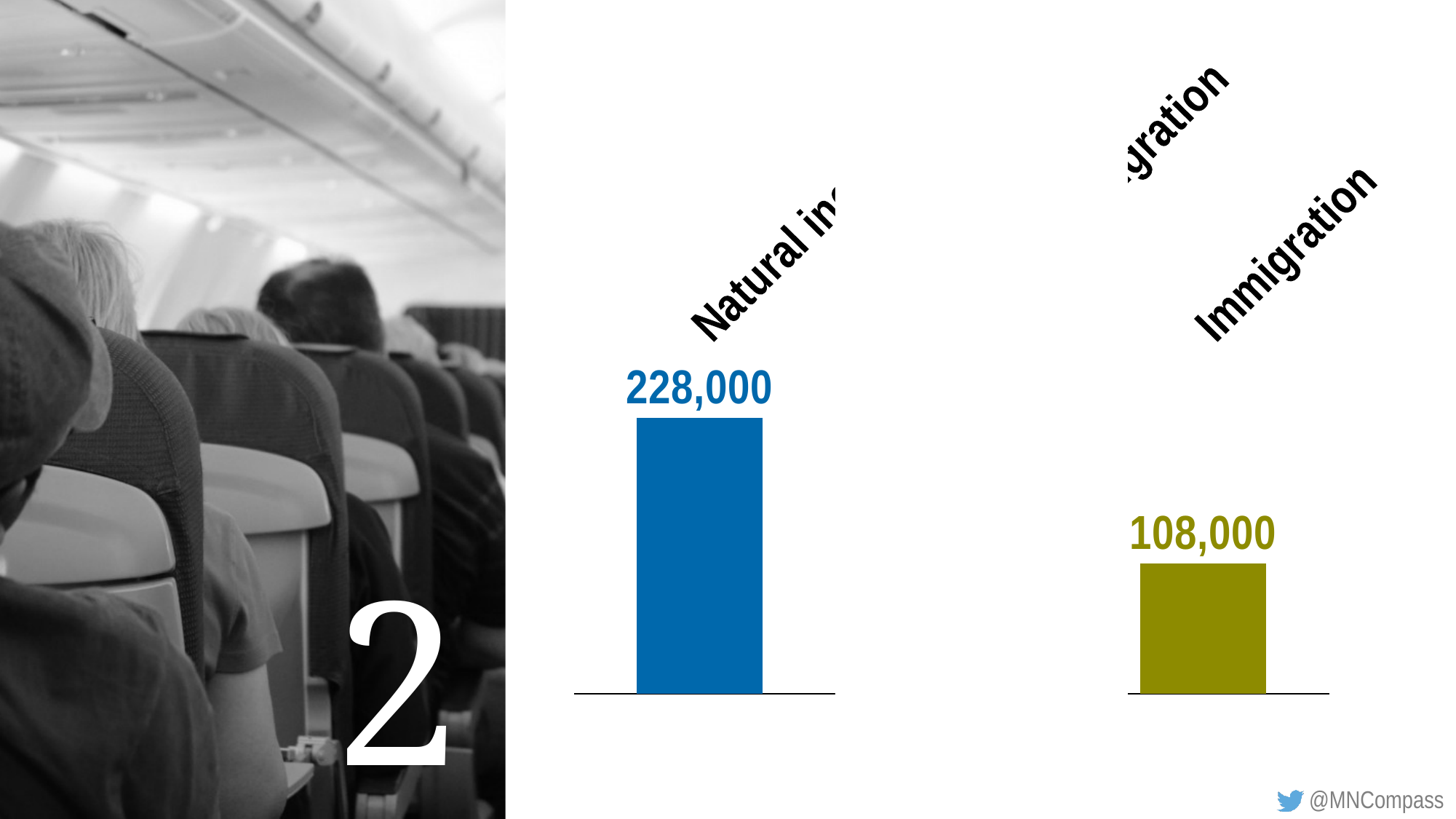
Which bar is the tallest in the chart? The blue bar on the left (228,000) What colour is the bar labelled 228,000? Blue Is the value for Immigration greater or less than the value of the blue bar? less What value is shown on the blue bar on the left of the chart? 228,000 How many bars are plotted in the chart? 2 What kind of chart is shown on the slide? Bar chart What colour is the Immigration bar? Olive green What is the difference between the left bar's value (228,000) and the Immigration value? 120,000 Which is larger: the value of the blue bar on the left or the value for Immigration? The blue bar on the left What value is shown for Immigration? 108,000